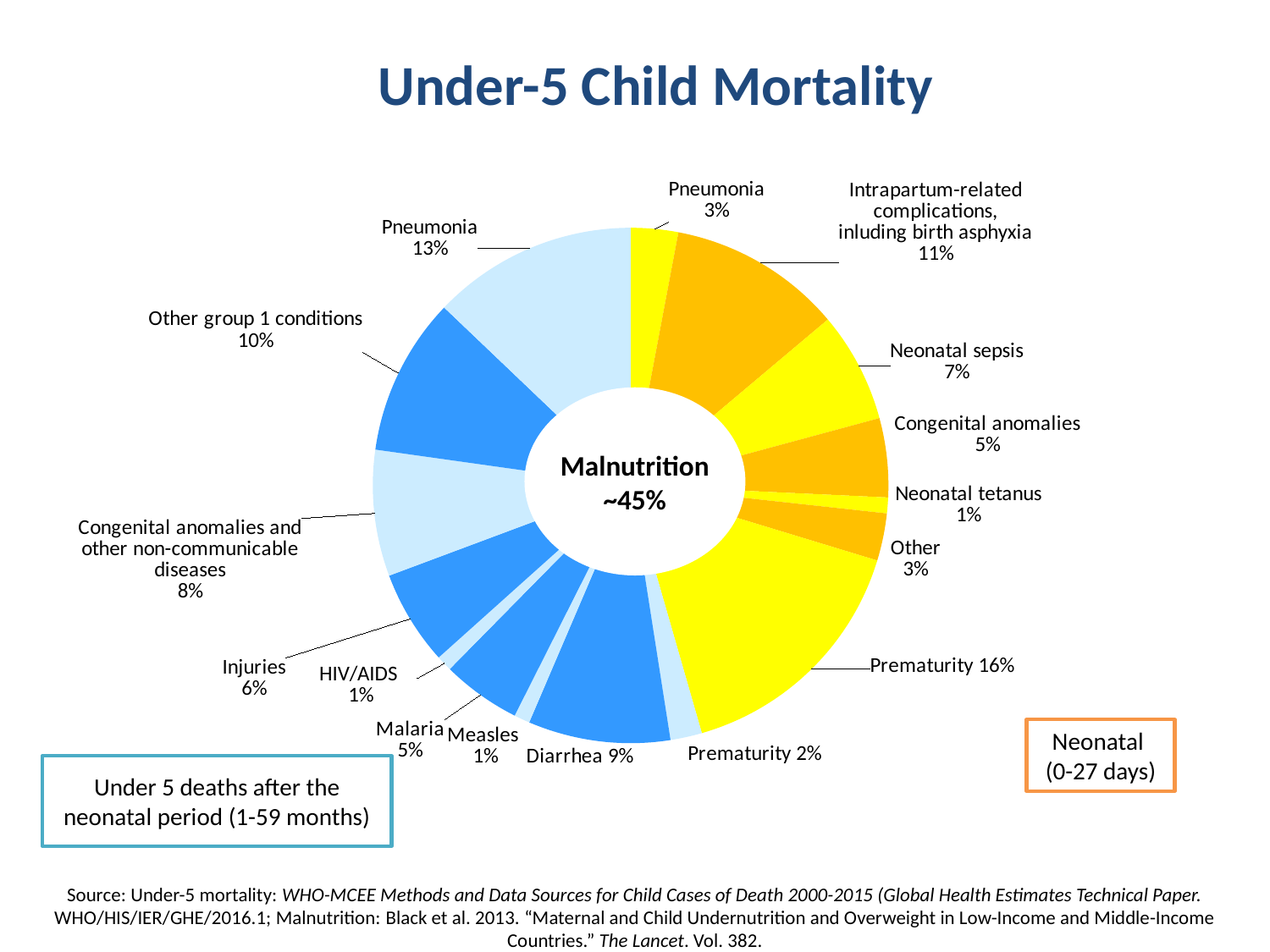
Which is larger, the share for Malaria or the share for Congenital anomalies and other non-communicable diseases? Congenital anomalies and other non-communicable diseases What percentage is shown for Intrapartum-related complications, including birth asphyxia? 11% How many slices does the chart have? 16 What percentage is shown for Prematurity in the neonatal (0-27 days) group? 16% What is the title of the chart? Under-5 Child Mortality What kind of chart is shown on the slide? pie chart What percentage is shown for Pneumonia in the under 5 deaths after the neonatal period (1-59 months) group? 13% What is the difference between the Other group 1 conditions share and the Injuries share? 4% What percentage is shown for Neonatal sepsis? 7% Which cause has the largest share of the chart? Prematurity (neonatal), 16% What text is shown in the centre of the chart? Malnutrition ~45% What percentage is shown for Diarrhea? 9%